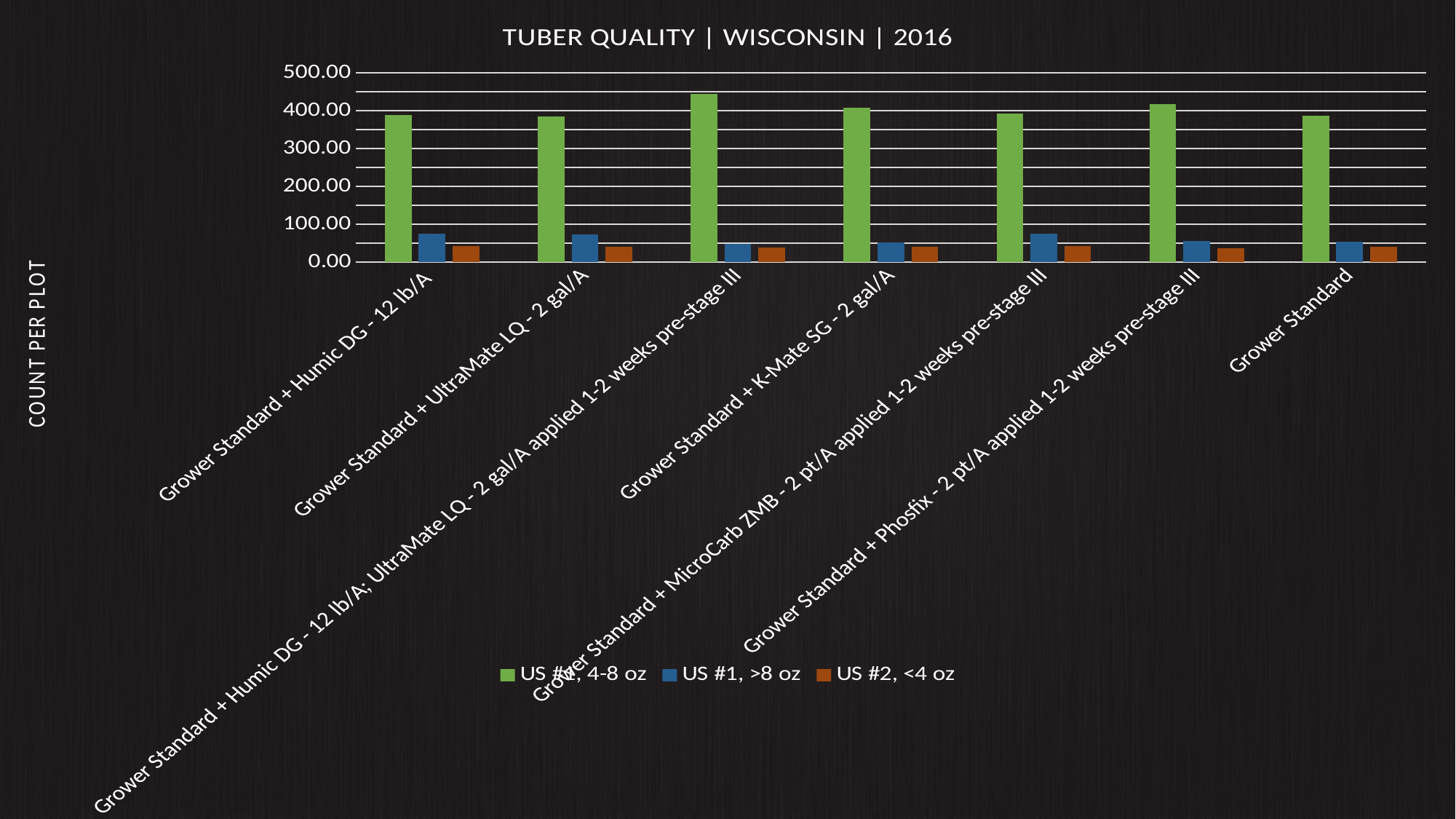
Is the US #1, 4-8 oz value for Grower Standard greater or less than 400.00? less How many series does the legend list? 3 What kind of chart is shown on the slide? bar chart Which series is shown in green in the legend? US #1, 4-8 oz Is the US #1, >8 oz value for Grower Standard + Humic DG - 12 lb/A greater or less than 100.00? less How many treatment categories are shown on the x axis? 7 Which has the larger US #1, 4-8 oz value: Grower Standard + Humic DG - 12 lb/A; UltraMate LQ - 2 gal/A applied 1-2 weeks pre-stage III or Grower Standard? Grower Standard + Humic DG - 12 lb/A; UltraMate LQ - 2 gal/A applied 1-2 weeks pre-stage III Which category has the highest value for US #1, 4-8 oz? Grower Standard + Humic DG - 12 lb/A; UltraMate LQ - 2 gal/A applied 1-2 weeks pre-stage III For Grower Standard + K-Mate SG - 2 gal/A, which is larger: US #1, 4-8 oz or US #2, <4 oz? US #1, 4-8 oz What is the title of the chart? TUBER QUALITY | WISCONSIN | 2016 Is the US #1, 4-8 oz value for Grower Standard + Phosfix - 2 pt/A applied 1-2 weeks pre-stage III greater or less than 400.00? greater